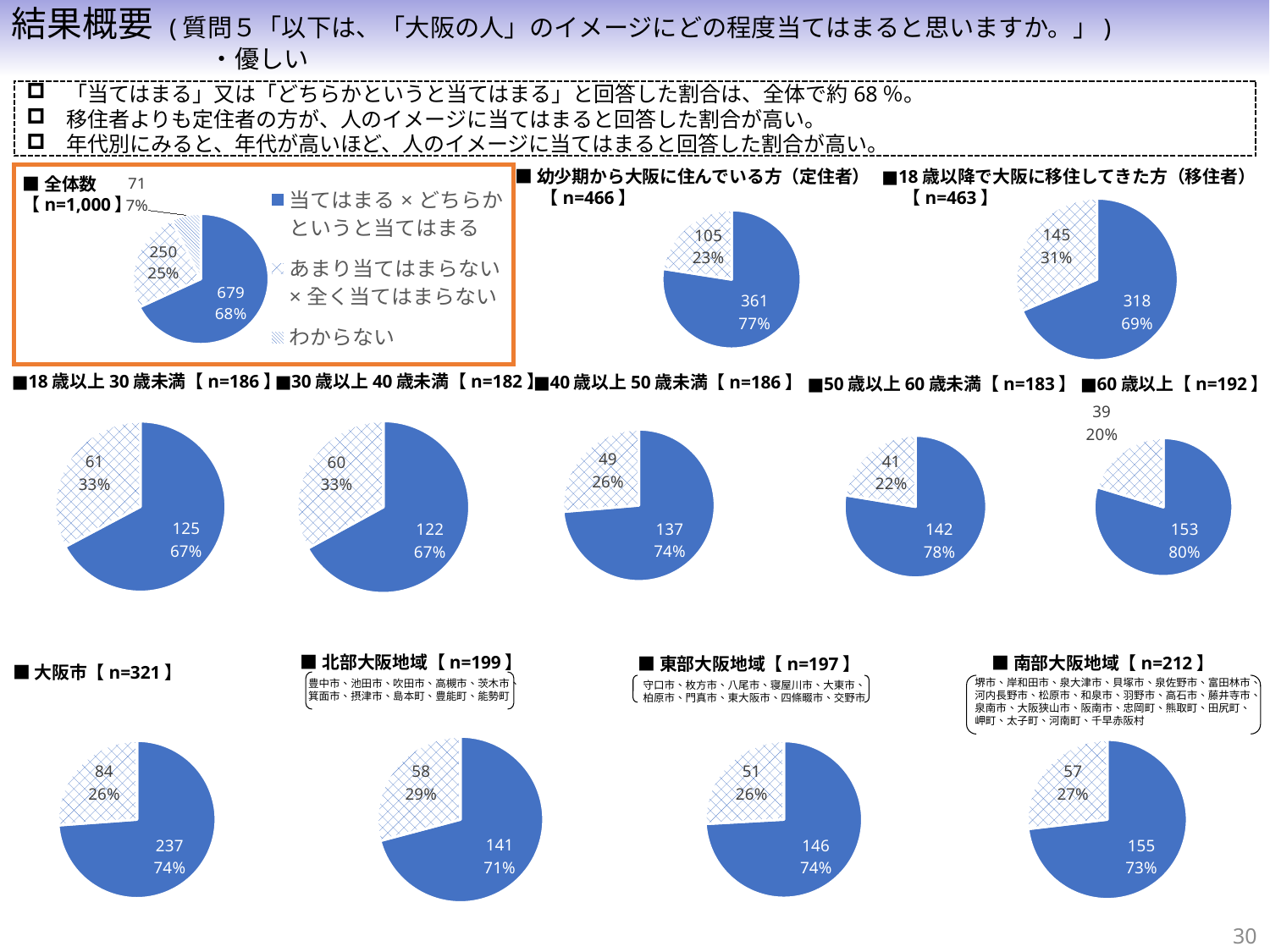
In the 18歳以降で大阪に移住してきた方（移住者）【n=463】 pie chart, what is the count for the smaller slice? 145 In the 全体数【n=1,000】 pie chart, what percentage is shown for 「わからない」? 7% In the 北部大阪地域【n=199】 pie chart, what percentage is shown for the smaller slice? 29% How many entries does the legend of the 全体数【n=1,000】 pie chart list? 3 What is the difference in count between the two slices of the 50歳以上60歳未満【n=183】 pie chart? 101 In the 幼少期から大阪に住んでいる方（定住者）【n=466】 pie chart, what percentage is shown for the larger slice? 77% Which is larger: the larger-slice percentage in the 定住者【n=466】 chart or in the 移住者【n=463】 chart? 定住者【n=466】 In the 大阪市【n=321】 pie chart, what is the count for the larger slice? 237 Among the five age-group pie charts, which age group has the highest percentage for the larger slice? 60歳以上【n=192】 In the 全体数【n=1,000】 pie chart, what is the count for 「当てはまる × どちらかというと当てはまる」? 679 What type of chart is used for the 幼少期から大阪に住んでいる方（定住者）【n=466】 data? Pie chart